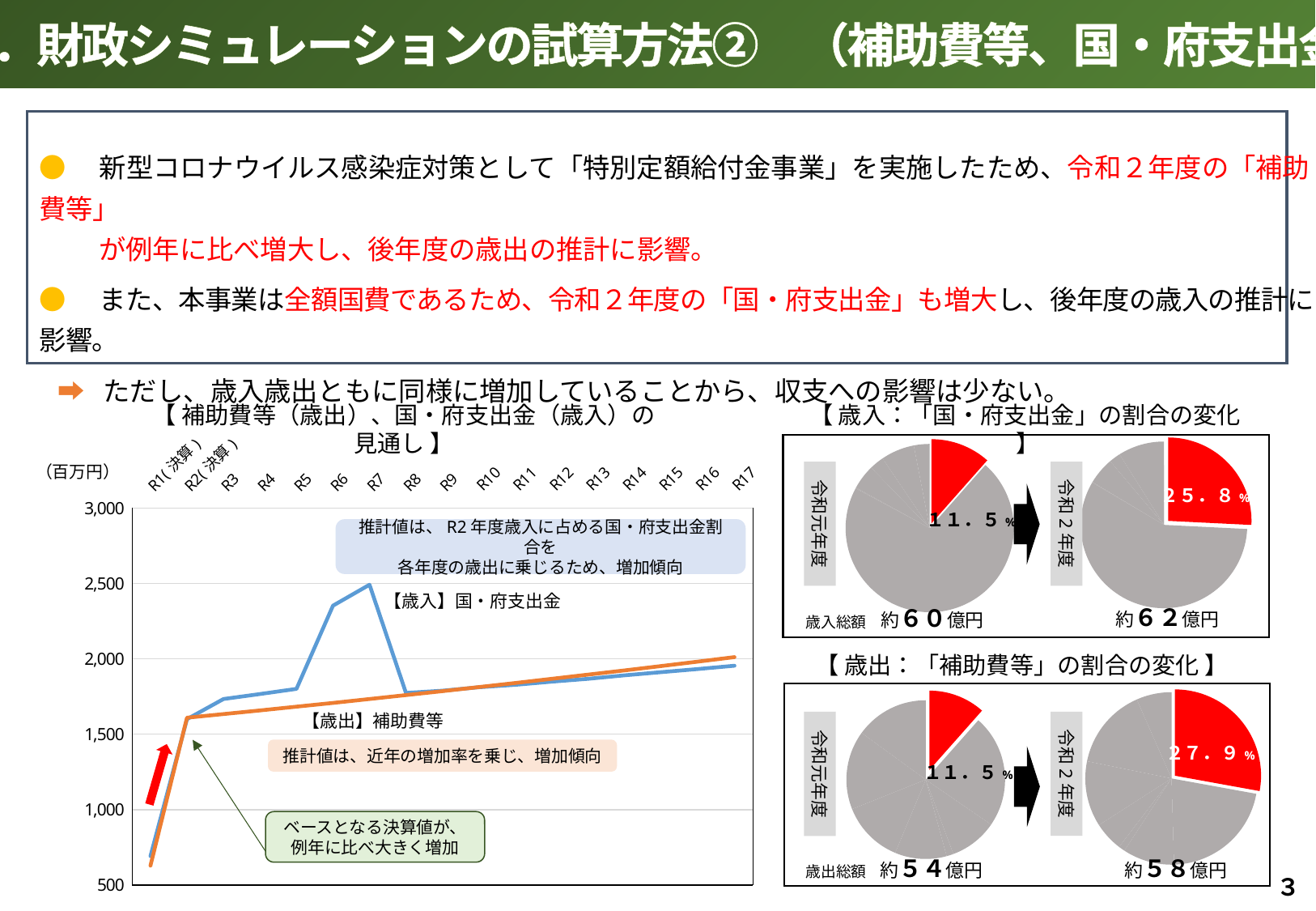
In the left line chart, which series is higher at R7, 【歳入】国・府支出金 or 【歳出】補助費等? 【歳入】国・府支出金 In the left line chart, how many series are plotted? 2 In the left line chart, is the value of 【歳出】補助費等 at R2(決算) greater or less than 2,000? less What kind of chart is the left chart titled 【補助費等（歳出）、国・府支出金（歳入）の見通し】? line chart In the 【歳出：「補助費等」の割合の変化】 pie charts, what is the 歳出総額 shown for 令和2年度? 約58億円 In the 【歳出：「補助費等」の割合の変化】 pie charts, what share does 補助費等 have in 令和2年度? 27.9% In the 【歳入：「国・府支出金」の割合の変化】 pie charts, what share does 国・府支出金 have in 令和元年度? 11.5% In the left line chart, how many year categories are shown on the x axis (R1 through R17)? 17 In the left line chart, does 【歳出】補助費等 rise or fall from R2 to R17? rise In the 【歳入：「国・府支出金」の割合の変化】 pie charts, what share does 国・府支出金 have in 令和2年度? 25.8% In the left line chart, is the value of 【歳入】国・府支出金 at R7 greater or less than 2,000? greater In the 【歳入：「国・府支出金」の割合の変化】 pie charts, by how many percentage points did the share increase from 令和元年度 to 令和2年度? 14.3